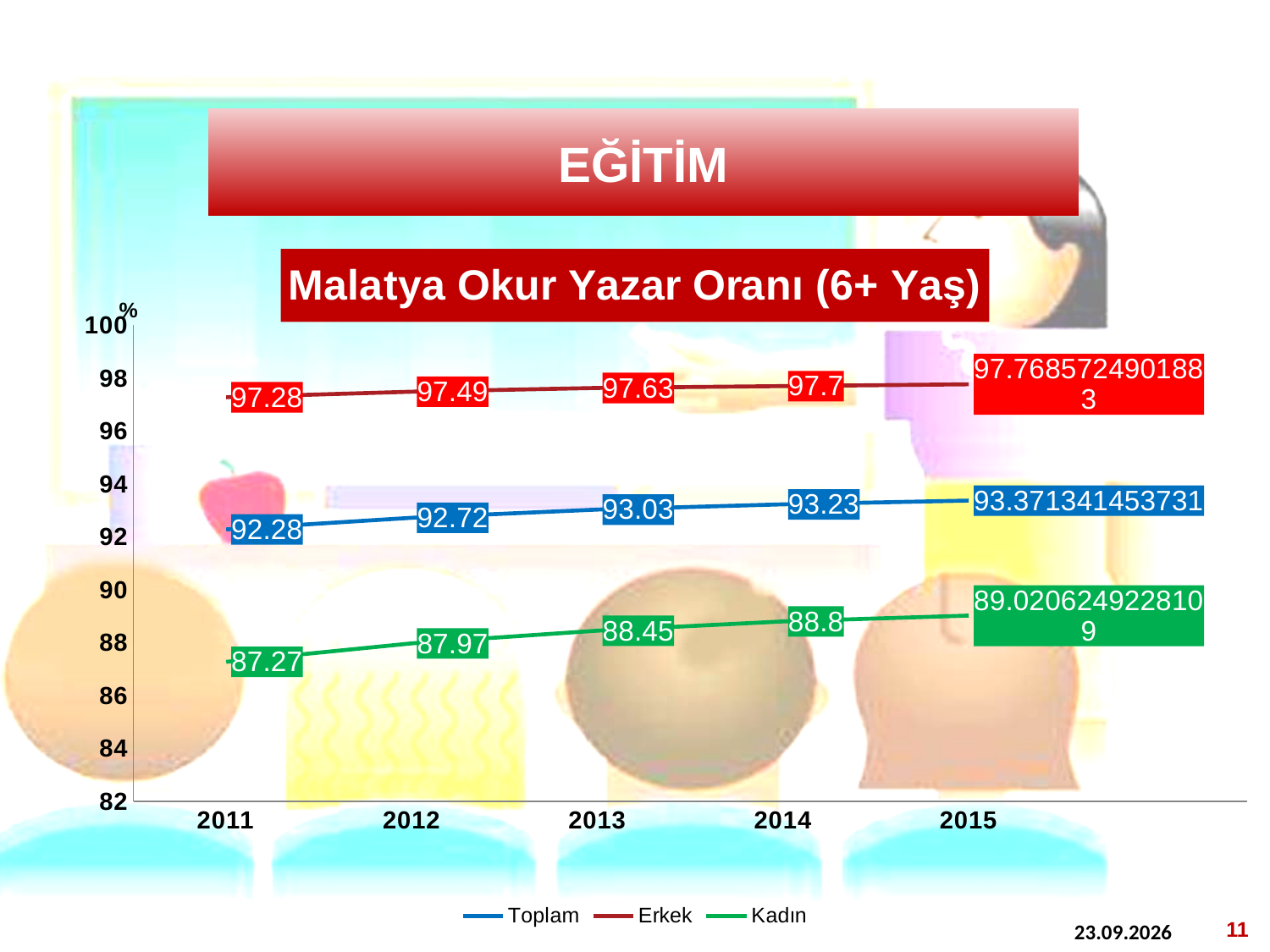
What is the Erkek value for 2011? 97.28 How many series does the legend list? 3 What is the Toplam value for 2013? 93.03 How many years are shown on the x axis? 5 What is the Kadın value for 2014? 88.8 What type of chart is shown on the slide? line chart What is the difference between the Erkek and Kadın values in 2014? 8.9 Is the Kadın value for 2015 greater or less than 90? less Which is larger, the Toplam value in 2012 or the Kadın value in 2013? Toplam value in 2012 Do the Toplam values rise or fall from 2011 to 2015? rise In which year is the Kadın value lowest? 2011 Which series has the highest values across all years? Erkek